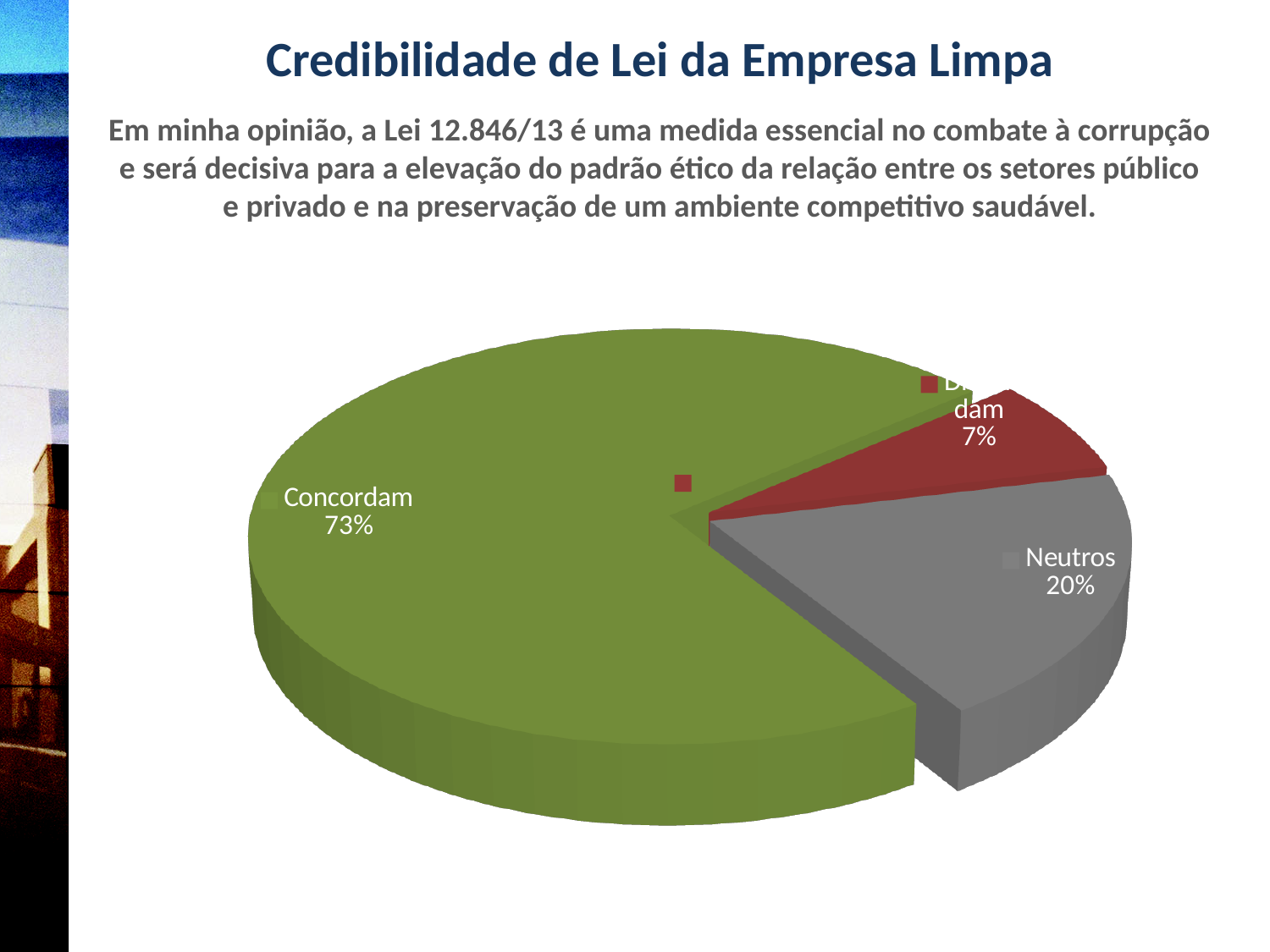
What is the title of the slide containing the chart? Credibilidade de Lei da Empresa Limpa What is the difference in percentage points between Concordam and Neutros? 53 percentage points What share of the pie does the red slice represent? 7% Which is larger, the share for Concordam or the share for Neutros? Concordam What colour is the Concordam slice? Green What kind of chart is shown on the slide? Pie chart Which category has the largest share of the pie? Concordam What share of the pie does Concordam represent? 73% What share of the pie does Neutros represent? 20% How many slices does the pie chart have? 3 What is the smallest percentage shown on the pie chart? 7%